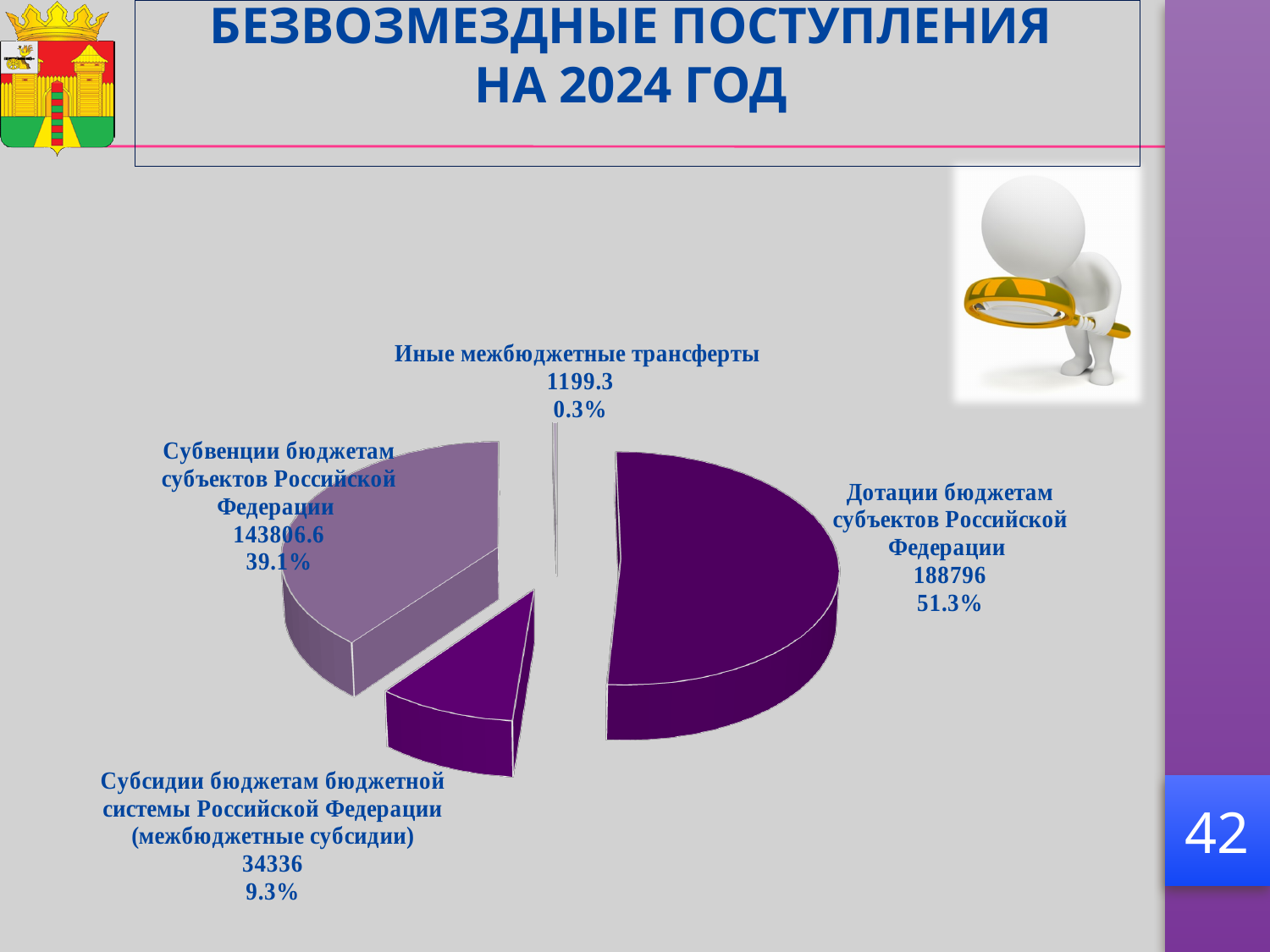
Which category has the largest share of the pie? Дотации бюджетам субъектов Российской Федерации Which is larger: the value for Субсидии бюджетам бюджетной системы Российской Федерации (межбюджетные субсидии) or Иные межбюджетные трансферты? Субсидии бюджетам бюджетной системы Российской Федерации (межбюджетные субсидии) Which category has the smallest share of the pie? Иные межбюджетные трансферты What is the value for Дотации бюджетам субъектов Российской Федерации? 188796 How many slices does the pie chart have? 4 What is the value for Субсидии бюджетам бюджетной системы Российской Федерации (межбюджетные субсидии)? 34336 What share of the pie does Субвенции бюджетам субъектов Российской Федерации represent? 39.1% What is the value for Субвенции бюджетам субъектов Российской Федерации? 143806.6 What type of chart is shown on the slide? pie chart What is the difference between the values for Дотации бюджетам субъектов Российской Федерации and Субвенции бюджетам субъектов Российской Федерации? 44989.4 What share of the pie does Субсидии бюджетам бюджетной системы Российской Федерации (межбюджетные субсидии) represent? 9.3% What is the value for Иные межбюджетные трансферты? 1199.3